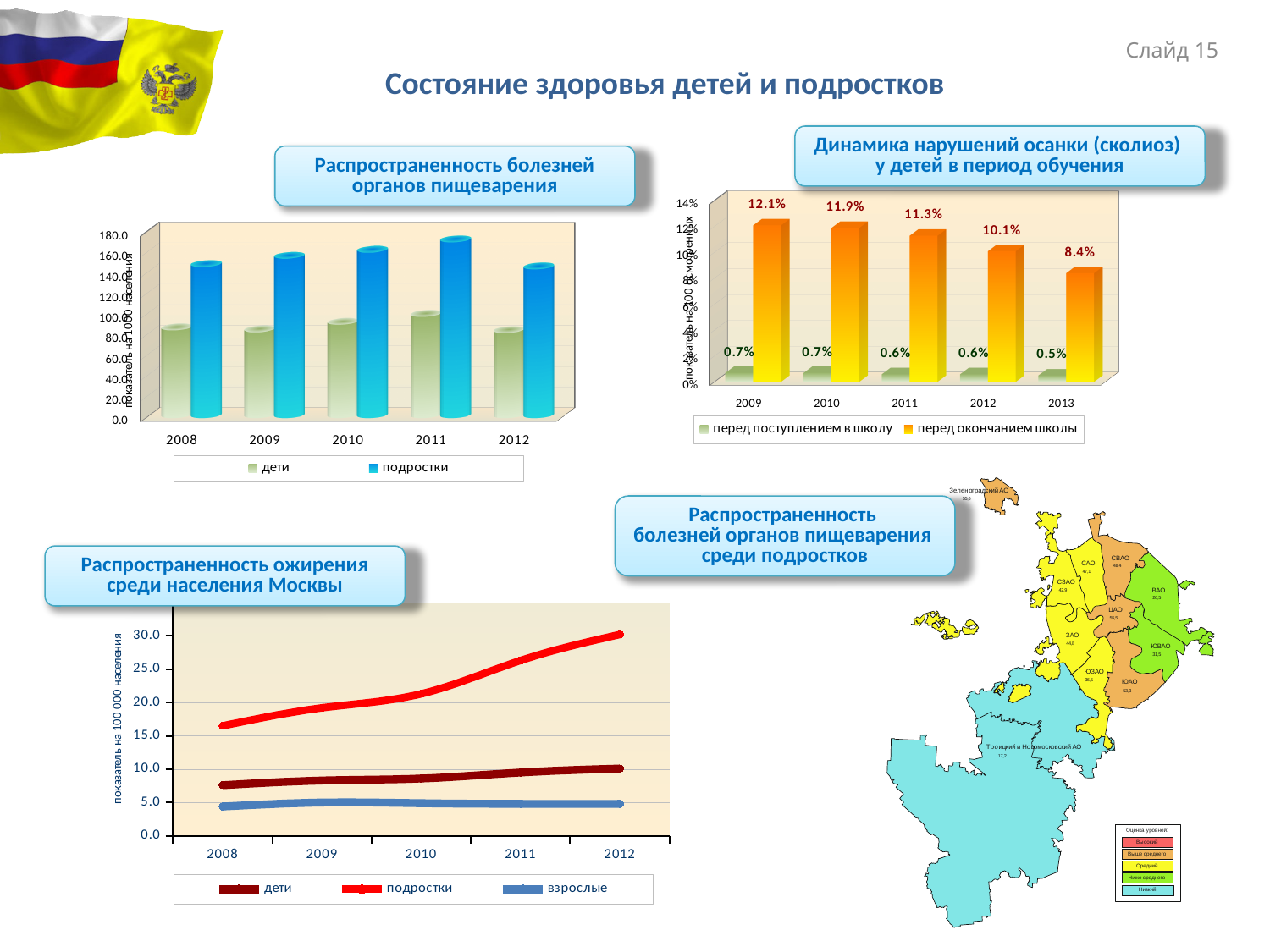
In the chart 'Динамика нарушений осанки (сколиоз) у детей в период обучения', what is the value for 'перед поступлением в школу' in 2013? 0.5% In the chart 'Динамика нарушений осанки (сколиоз) у детей в период обучения', how many years are shown on the x axis? 5 In the chart 'Распространенность ожирения среди населения Москвы', how many series does the legend list? 3 In the chart 'Распространенность ожирения среди населения Москвы', is the value for 'подростки' in 2012 greater or less than 25.0? greater What kind of chart is 'Распространенность болезней органов пищеварения'? bar chart In the chart 'Распространенность болезней органов пищеварения', which series has the larger value in 2010, 'дети' or 'подростки'? подростки In the chart 'Динамика нарушений осанки (сколиоз) у детей в период обучения', do the values for 'перед окончанием школы' rise or fall from 2009 to 2013? fall In the chart 'Распространенность болезней органов пищеварения', how many series does the legend list? 2 In the chart 'Распространенность болезней органов пищеварения', is the value for 'дети' in 2008 greater or less than 120.0? less In the chart 'Динамика нарушений осанки (сколиоз) у детей в период обучения', what is the difference between the 'перед окончанием школы' values for 2009 and 2013? 3.7% In the chart 'Динамика нарушений осанки (сколиоз) у детей в период обучения', what is the value for 'перед окончанием школы' in 2009? 12.1% In the chart 'Динамика нарушений осанки (сколиоз) у детей в период обучения', which year has the highest value for 'перед окончанием школы'? 2009